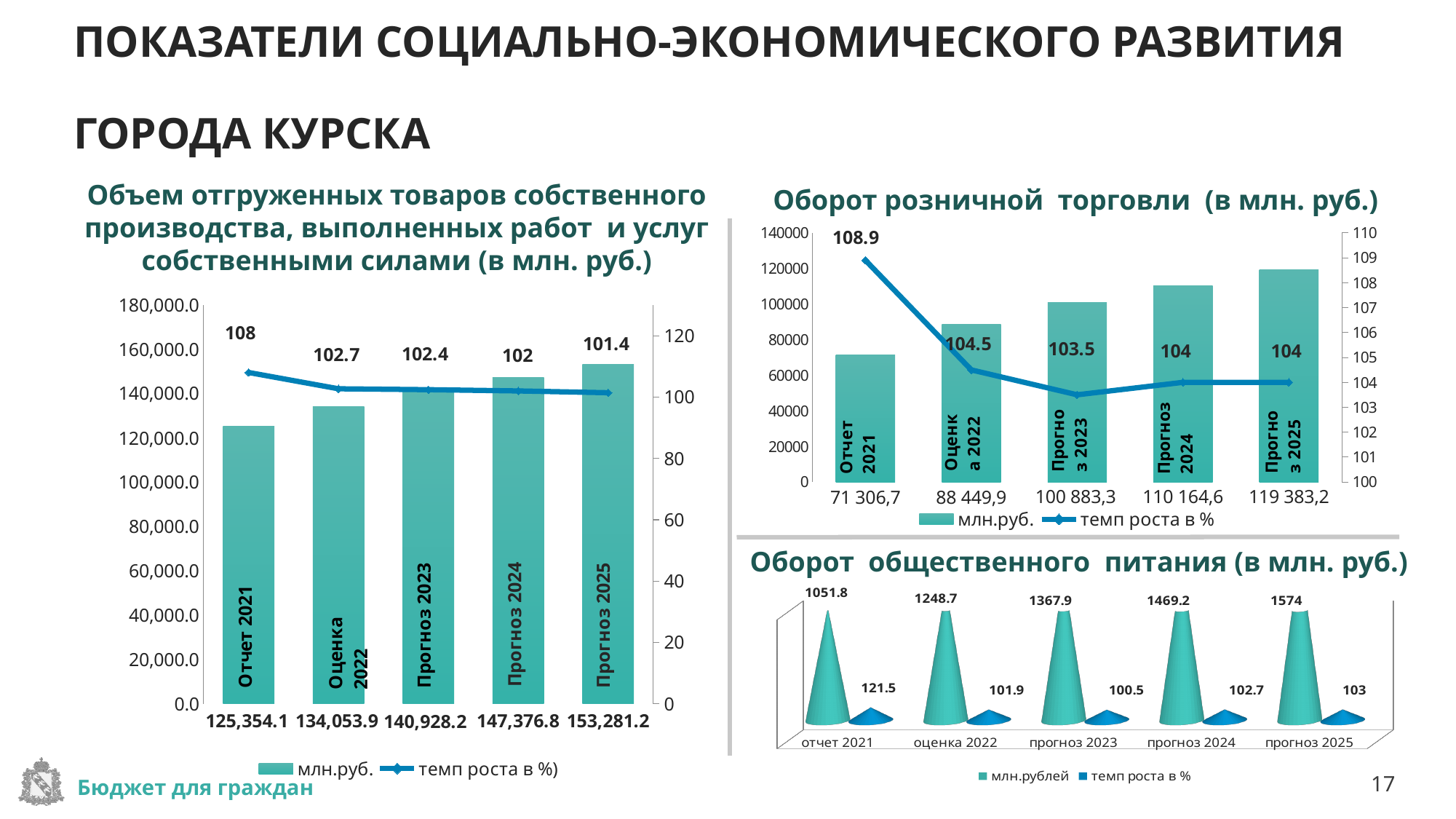
In the chart 'Оборот розничной торговли (в млн. руб.)', what is the темп роста в % value for Оценка 2022? 104.5 In the chart 'Объем отгруженных товаров собственного производства...' on the left, what is the темп роста в % value for Отчет 2021? 108 In the chart 'Объем отгруженных товаров собственного производства...' on the left, do the bar values rise or fall from Отчет 2021 to Прогноз 2025? rise In the chart 'Оборот розничной торговли (в млн. руб.)', how many series does the legend list? 2 In the chart 'Оборот общественного питания (в млн. руб.)', which category has the highest темп роста в % value? отчет 2021 In the chart 'Объем отгруженных товаров собственного производства...' on the left, what is the value in млн.руб. for Прогноз 2025? 153,281.2 In the chart 'Оборот розничной торговли (в млн. руб.)', what is the value for Прогноз 2023? 100 883,3 In the chart 'Оборот общественного питания (в млн. руб.)', how many categories are shown on the x axis? 5 In the chart 'Оборот розничной торговли (в млн. руб.)', which category has the lowest bar value? Отчет 2021 In the chart 'Оборот общественного питания (в млн. руб.)', which is larger: the темп роста в % value for прогноз 2023 or for прогноз 2025? прогноз 2025 In the chart 'Объем отгруженных товаров собственного производства...' on the left, what is the difference in млн.руб. between Оценка 2022 and Отчет 2021? 8,699.8 In the chart 'Оборот общественного питания (в млн. руб.)', what is the млн.рублей value for прогноз 2024? 1469.2